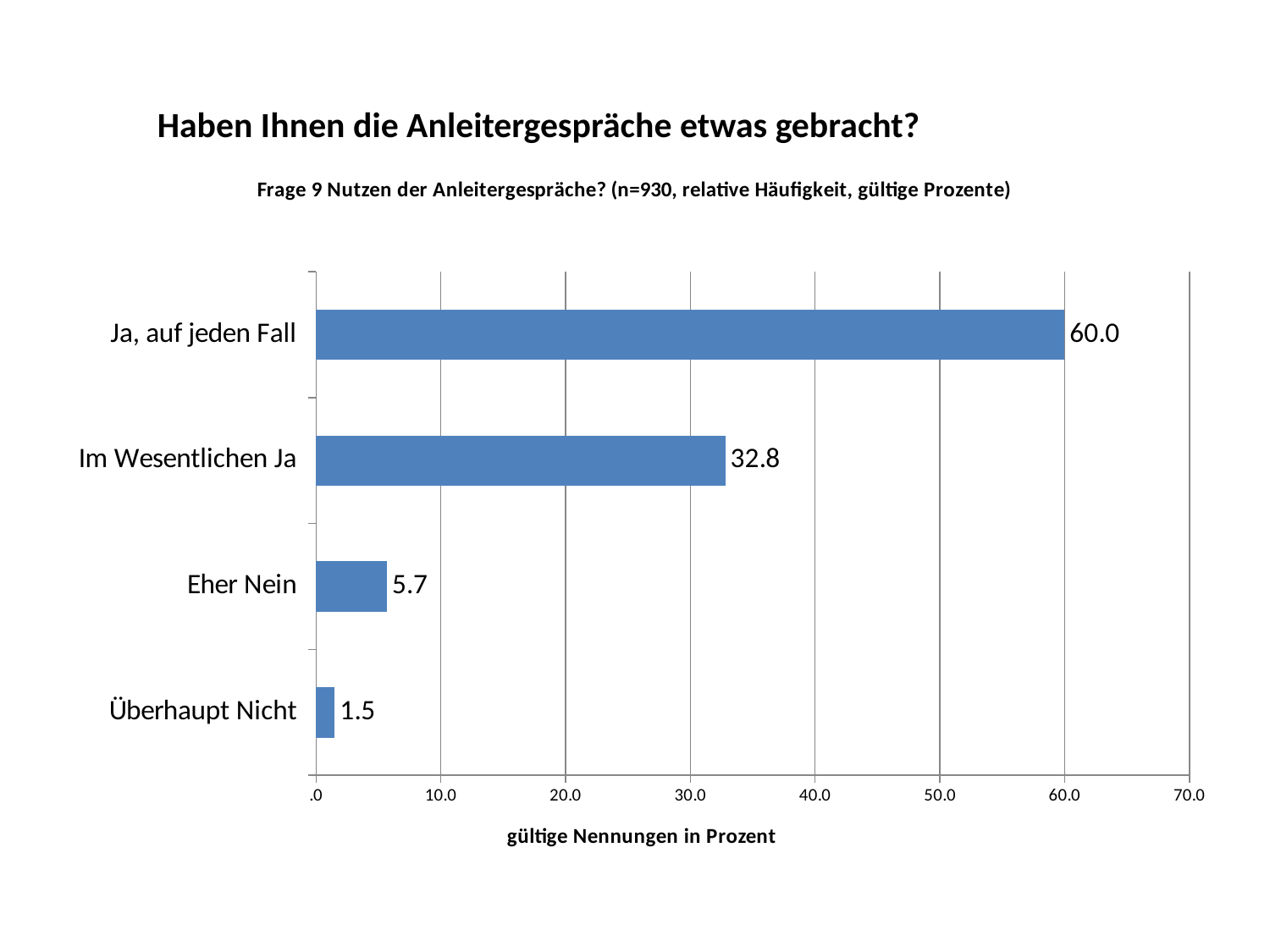
What kind of chart is shown on the slide? Bar chart What is the label of the horizontal axis? gültige Nennungen in Prozent What is the value for "Ja, auf jeden Fall"? 60.0 What is the difference between the values for "Ja, auf jeden Fall" and "Im Wesentlichen Ja"? 27.2 What is the value for "Im Wesentlichen Ja"? 32.8 Which is larger, the value for "Im Wesentlichen Ja" or the value for "Eher Nein"? Im Wesentlichen Ja What is the difference between the values for "Eher Nein" and "Überhaupt Nicht"? 4.2 What is the value for "Überhaupt Nicht"? 1.5 Which category has the lowest value? Überhaupt Nicht What is the value for "Eher Nein"? 5.7 Which category has the highest value? Ja, auf jeden Fall How many categories are shown in the chart? 4